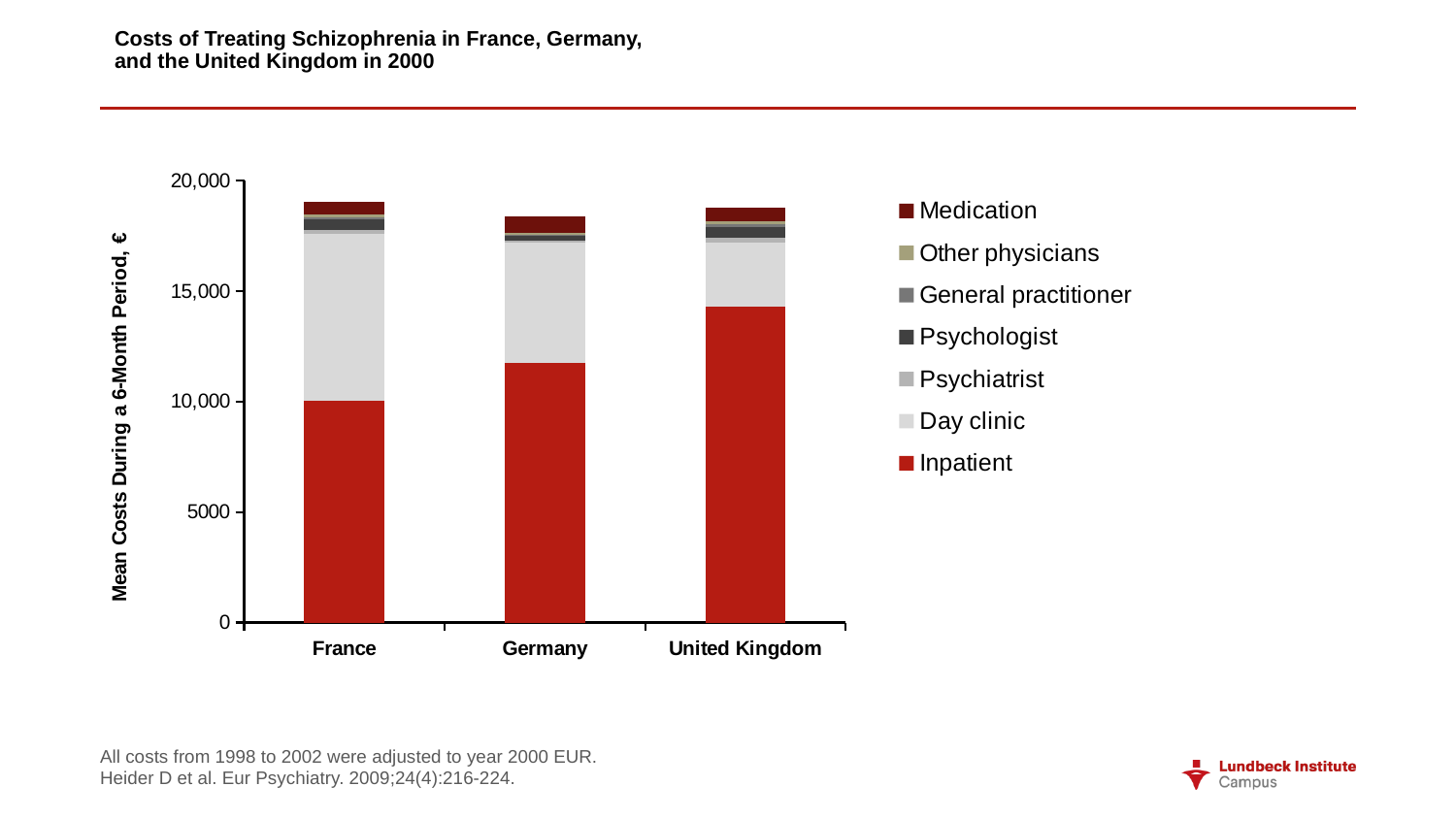
Is the Inpatient cost for the United Kingdom greater or less than 10,000? greater Which country has the largest Day clinic cost? France How many countries are shown on the x axis of the chart? 3 Is the Inpatient cost for France greater or less than 15,000? less Is the Inpatient cost larger for Germany or for the United Kingdom? United Kingdom Which country has the highest Inpatient cost? United Kingdom What is the label of the y axis? Mean Costs During a 6-Month Period, € Which country has the lowest Inpatient cost? France Which country has the smallest Day clinic cost? United Kingdom What kind of chart is shown on the slide? Stacked bar chart Is the total cost for Germany greater or less than 15,000? greater How many series does the chart's legend list? 7